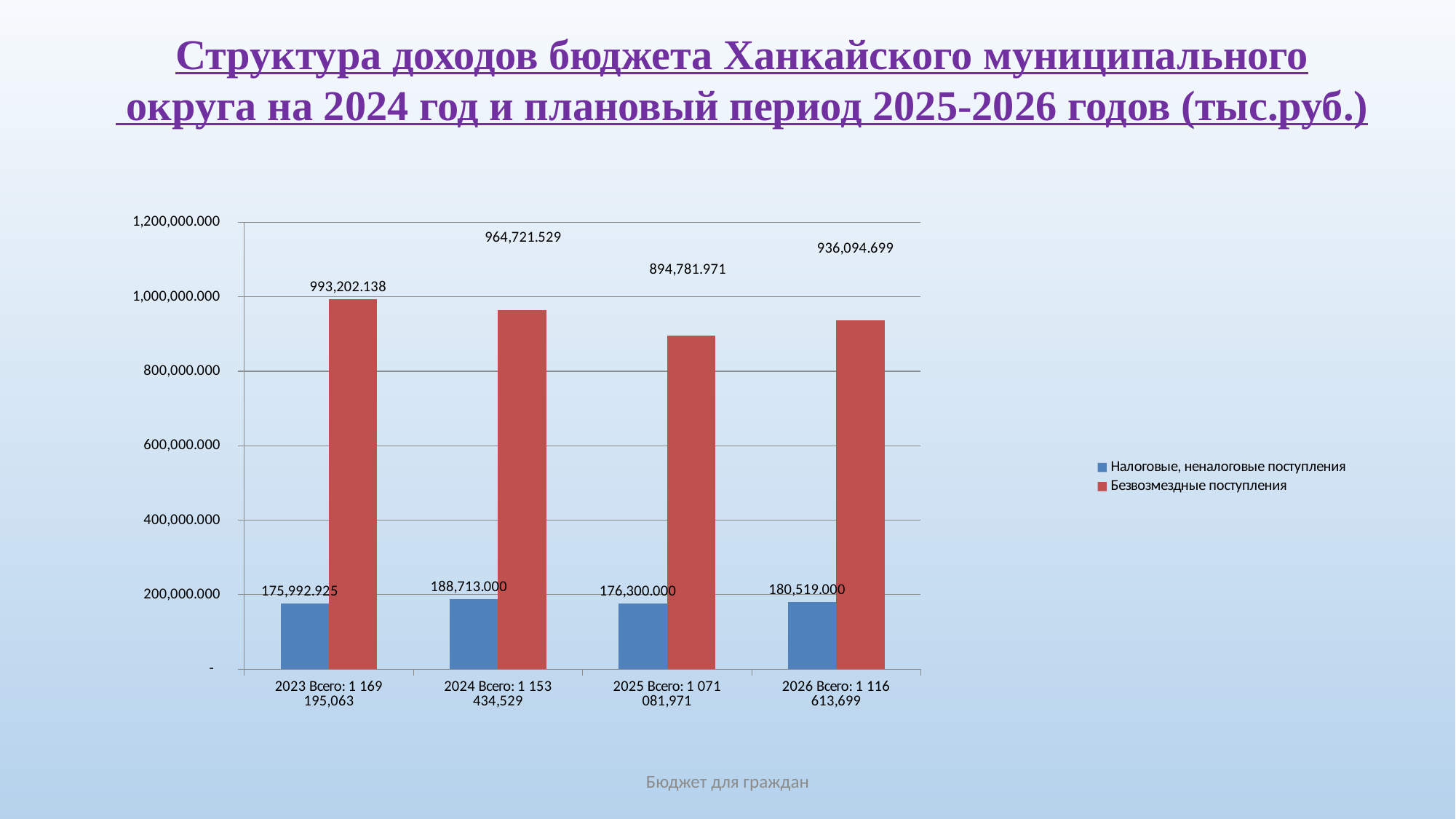
What kind of chart is shown on the slide? bar chart What is the value of Налоговые, неналоговые поступления for 2024? 188,713.000 Which is larger: Безвозмездные поступления in 2024 or in 2026? 2024 In which year is Безвозмездные поступления highest? 2023 What is the difference between Безвозмездные поступления in 2023 and in 2025? 98,420.167 Is the value of Безвозмездные поступления for 2025 greater or less than 800,000.000? greater How many years (categories) are shown on the x axis? 4 In which year is Безвозмездные поступления lowest? 2025 How many series does the legend list? 2 In which year is Налоговые, неналоговые поступления highest? 2024 What is the value of Безвозмездные поступления for 2023? 993,202.138 What is the value of Безвозмездные поступления for 2026? 936,094.699